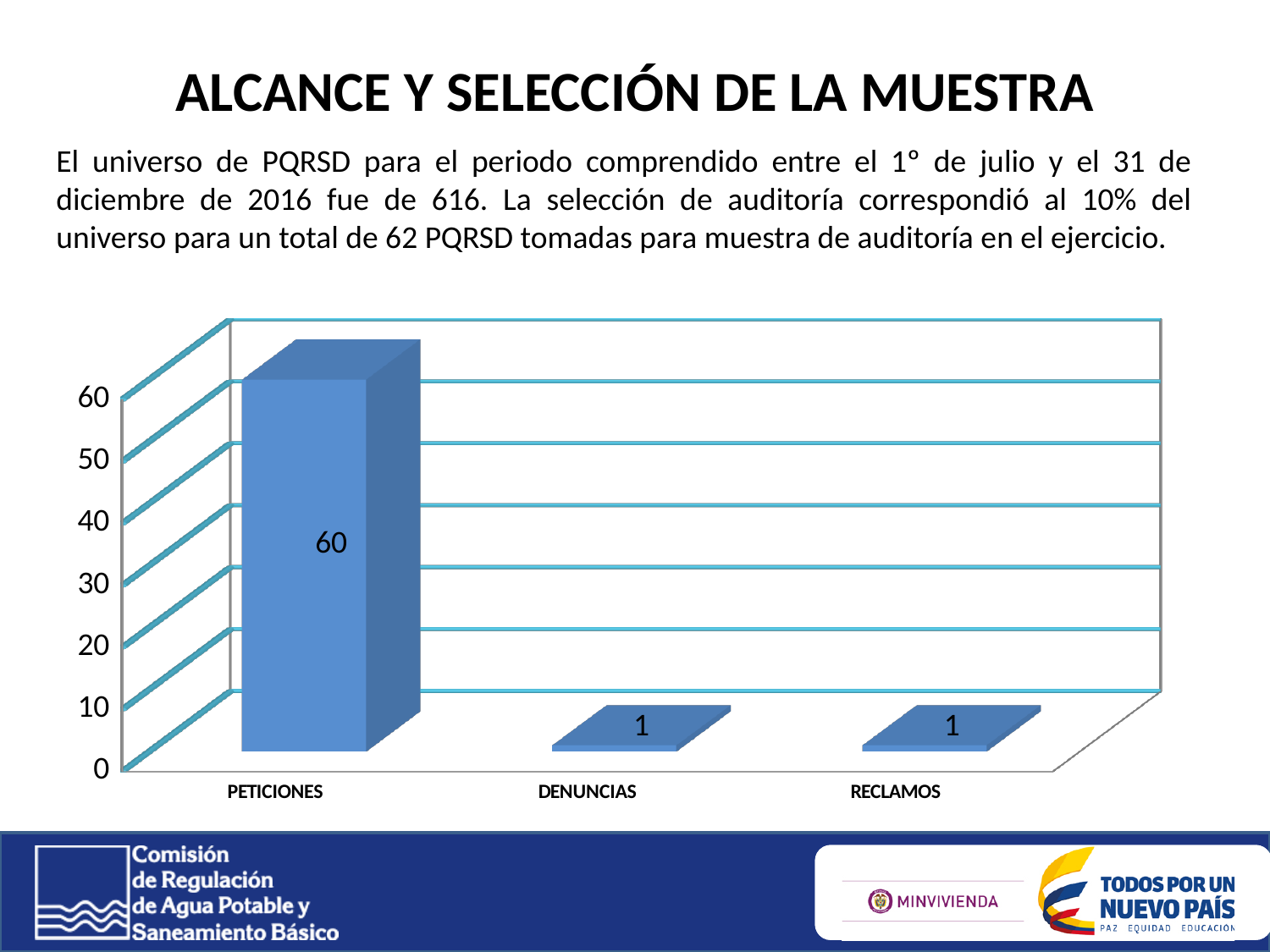
What kind of chart is shown on the slide? bar chart Is the value for PETICIONES greater or less than 50? greater What is the value for DENUNCIAS? 1 Is the value for DENUNCIAS greater or less than 10? less How many categories are shown on the x axis? 3 What is the value for PETICIONES? 60 Which category has the highest value? PETICIONES What is the highest tick value shown on the vertical axis? 60 Which is larger, the value for PETICIONES or the value for RECLAMOS? PETICIONES What is the value for RECLAMOS? 1 What is the difference between the values for PETICIONES and DENUNCIAS? 59 What is the total of the three plotted values? 62